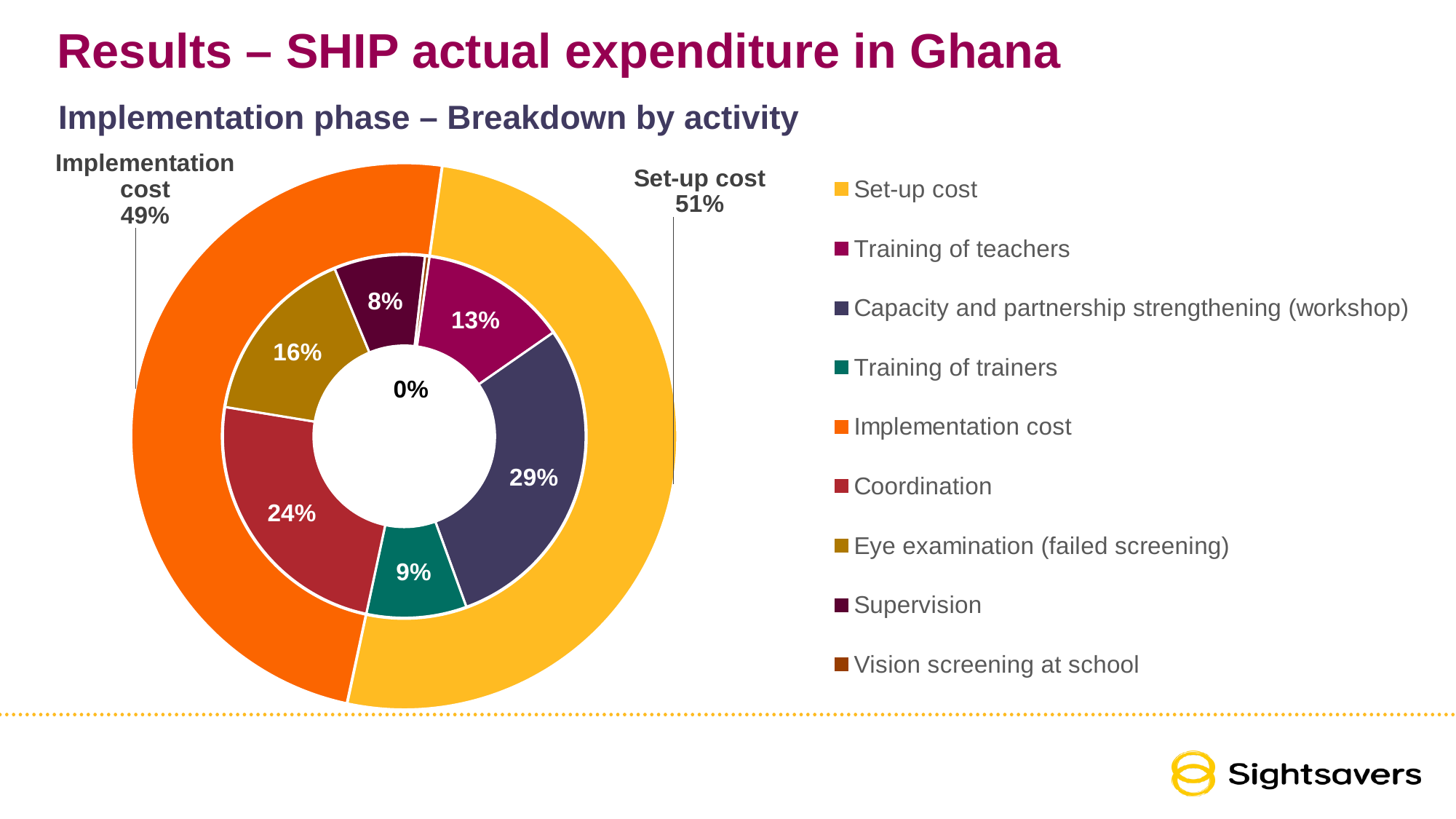
What share of expenditure does the outer ring show for Implementation cost? 49% What percentage is shown for Training of trainers? 9% What is the difference in percentage points between Coordination and Eye examination (failed screening)? 8 What percentage is shown for Capacity and partnership strengthening (workshop) in the inner ring? 29% Which activity in the inner ring has the largest share? Capacity and partnership strengthening (workshop) What kind of chart is shown on the slide? Doughnut chart What share of expenditure does the outer ring show for Set-up cost? 51% What percentage is shown for Coordination in the inner ring? 24% Which is larger, the share for Training of teachers or the share for Supervision? Training of teachers How many entries does the legend list? 9 Which activity in the inner ring has the smallest share? Vision screening at school What is the subtitle of the chart? Implementation phase – Breakdown by activity